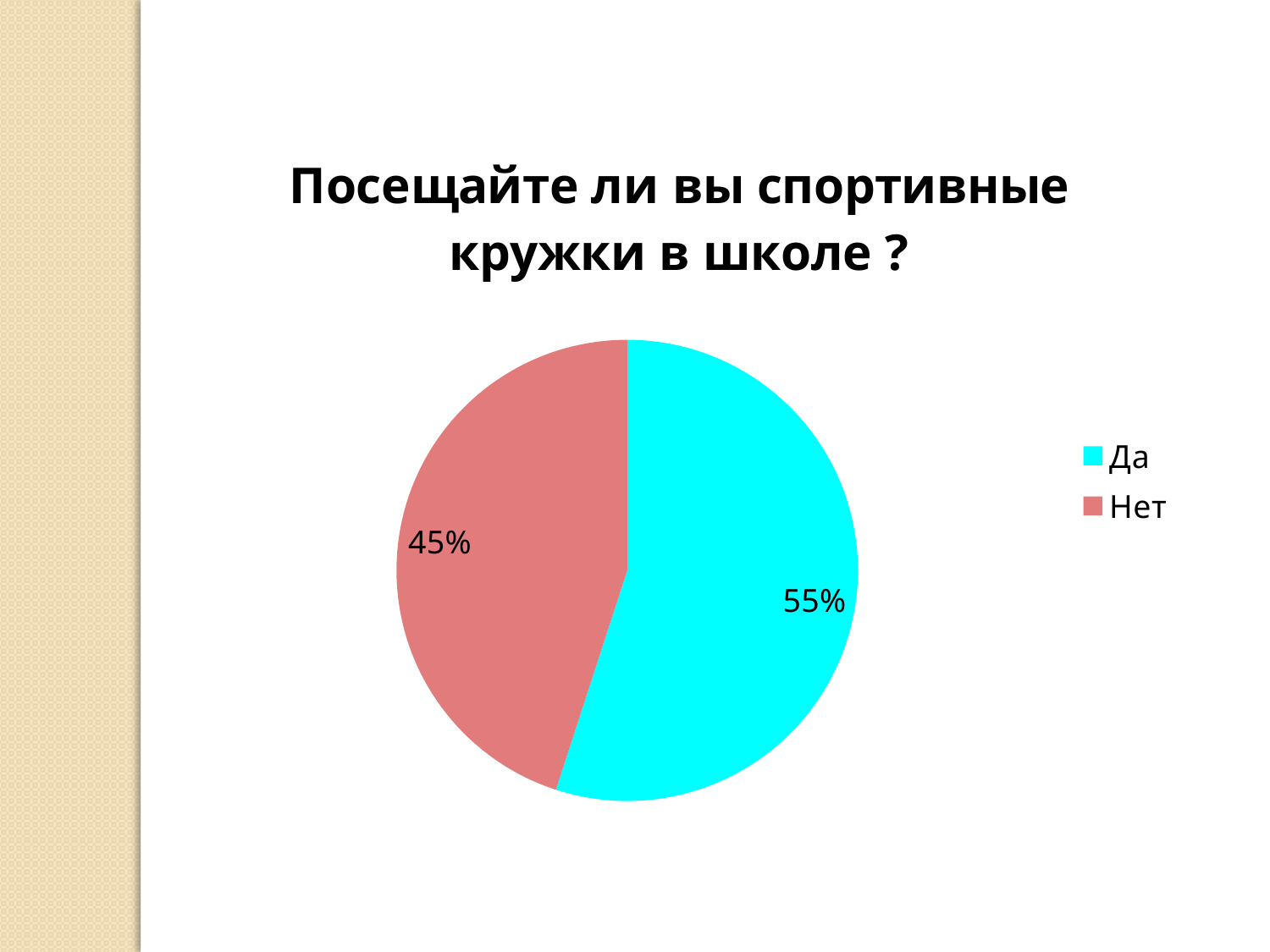
What share of the pie does the Нет slice represent? 45% What kind of chart is shown on the slide? pie chart What is the difference between the values for Да and Нет? 10% What is the value for Да? 55% How many slices does the pie chart have? 2 How many entries does the legend list? 2 What is the title of the chart? Посещайте ли вы спортивные кружки в школе ? Which is larger, the value for Да or the value for Нет? Да Which category has the largest share of the pie? Да Which category has the smallest share of the pie? Нет What colour is the slice for Да? cyan What is the value for Нет? 45%